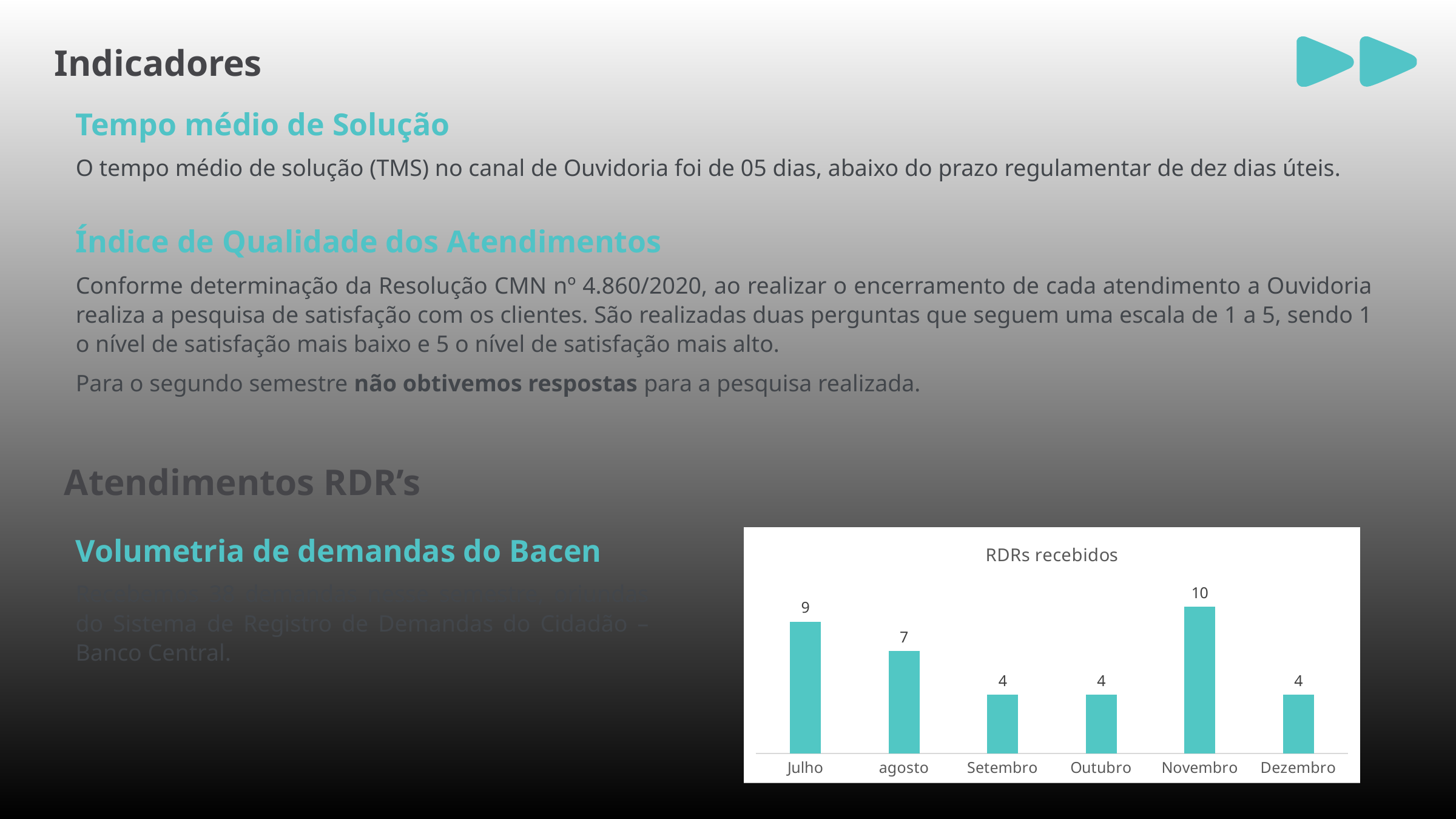
Which month has the highest value in the RDRs recebidos chart? Novembro How many months in the RDRs recebidos chart have a value of 4? 3 What is the value for agosto in the RDRs recebidos chart? 7 What kind of chart is the RDRs recebidos chart? bar chart What is the value for Setembro in the RDRs recebidos chart? 4 What is the value for Novembro in the RDRs recebidos chart? 10 What is the difference between the values for Novembro and Julho in the RDRs recebidos chart? 1 What is the title of the chart on the slide? RDRs recebidos What is the difference between the values for agosto and Outubro in the RDRs recebidos chart? 3 How many months are shown in the RDRs recebidos chart? 6 Which is larger in the RDRs recebidos chart, the value for Julho or the value for agosto? Julho What is the value for Julho in the RDRs recebidos chart? 9